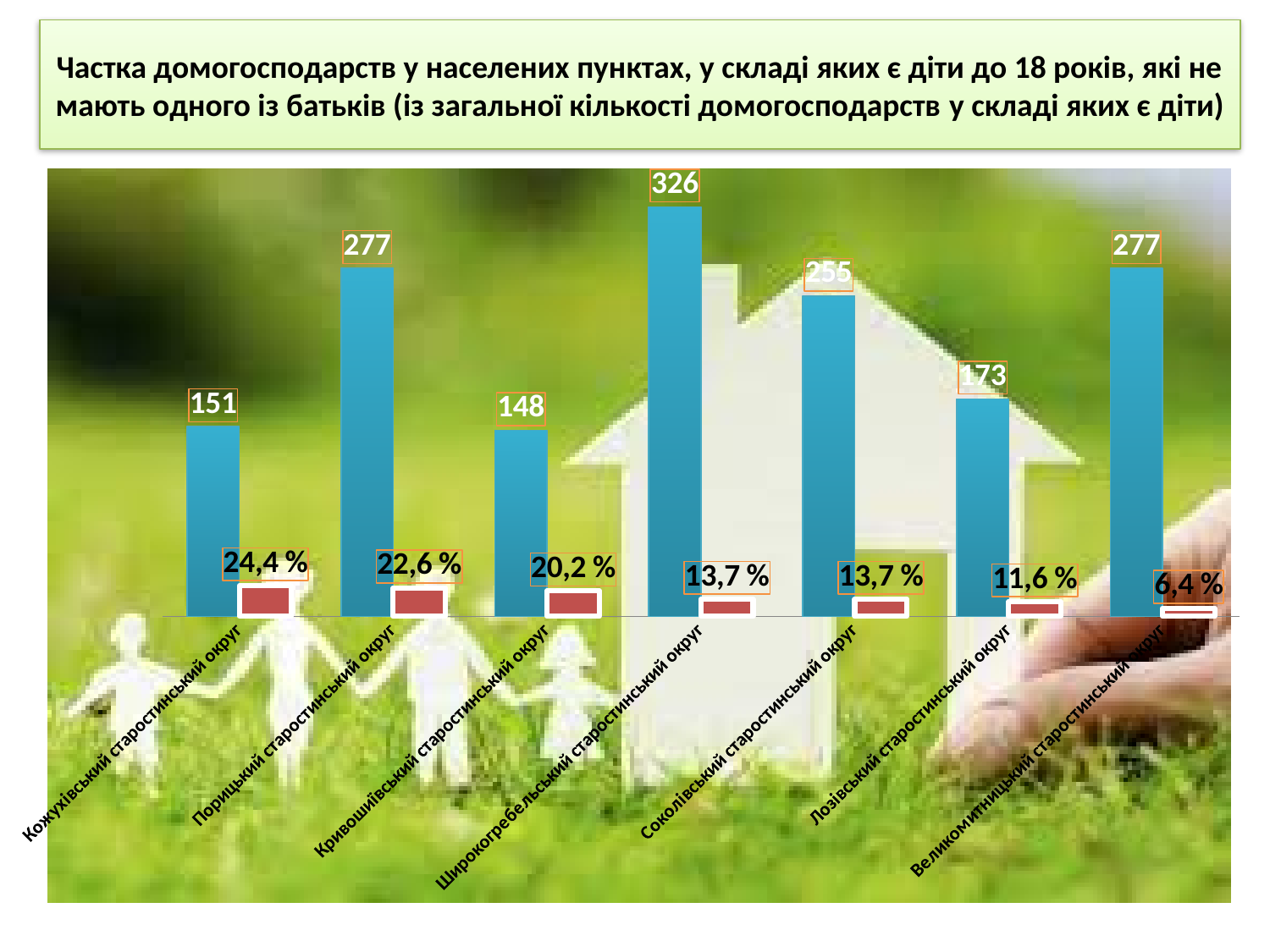
Do the percentage values rise or fall from left to right along the x axis? Fall What percentage is shown for Великомитницький старостинський округ? 6,4 % Which category has the lowest percentage value? Великомитницький старостинський округ Which has a higher percentage: Порицький старостинський округ or Лозівський старостинський округ? Порицький старостинський округ Which category has the lowest blue bar value? Кривошиївський старостинський округ What is the blue bar value for Широкогребельський старостинський округ? 326 Which category has the highest blue bar value? Широкогребельський старостинський округ How many categories are shown on the x axis? 7 What is the difference between the blue bar values for Широкогребельський and Соколівський старостинський округ? 71 What is the blue bar value for Лозівський старостинський округ? 173 What percentage is shown for Кожухівський старостинський округ? 24,4 % What kind of chart is shown on the slide? Bar chart